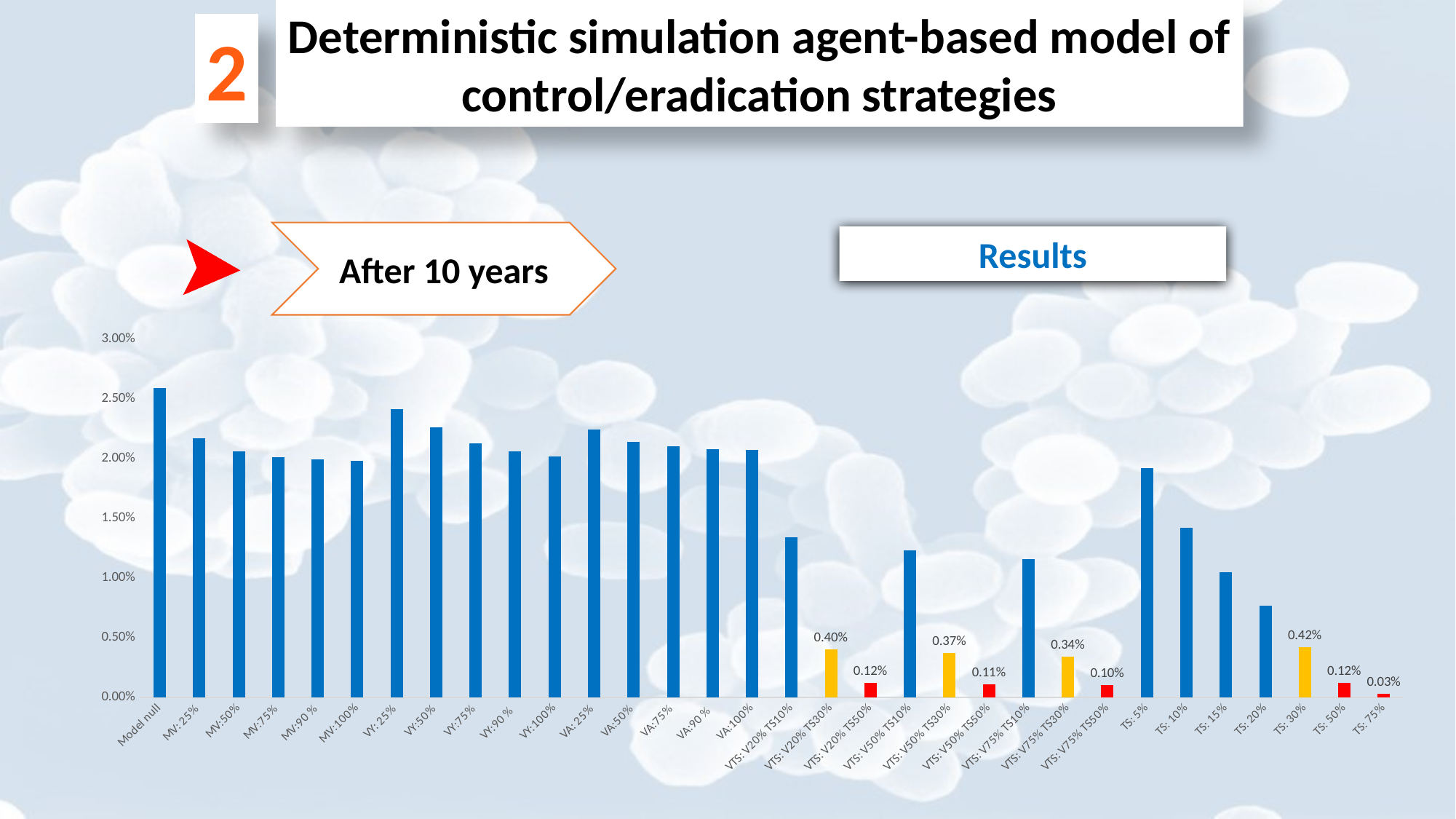
What is the difference between the values for VTS: V20% TS30% and VTS: V20% TS50%? 0.28% What is the value for VTS: V50% TS50%? 0.11% What is the value for TS: 75%? 0.03% Is the value for TS: 20% greater or less than 1.00%? less Is the value for Model null greater or less than 2.50%? greater Which category has the highest value? Model null What is the value for TS: 30%? 0.42% What text is shown in the arrow-shaped label above the chart? After 10 years What type of chart is shown on the slide? bar chart Which category has the lowest value? TS: 75% Which is larger, the value for VTS: V50% TS30% or VTS: V75% TS30%? VTS: V50% TS30% What is the value for VTS: V20% TS30%? 0.40%